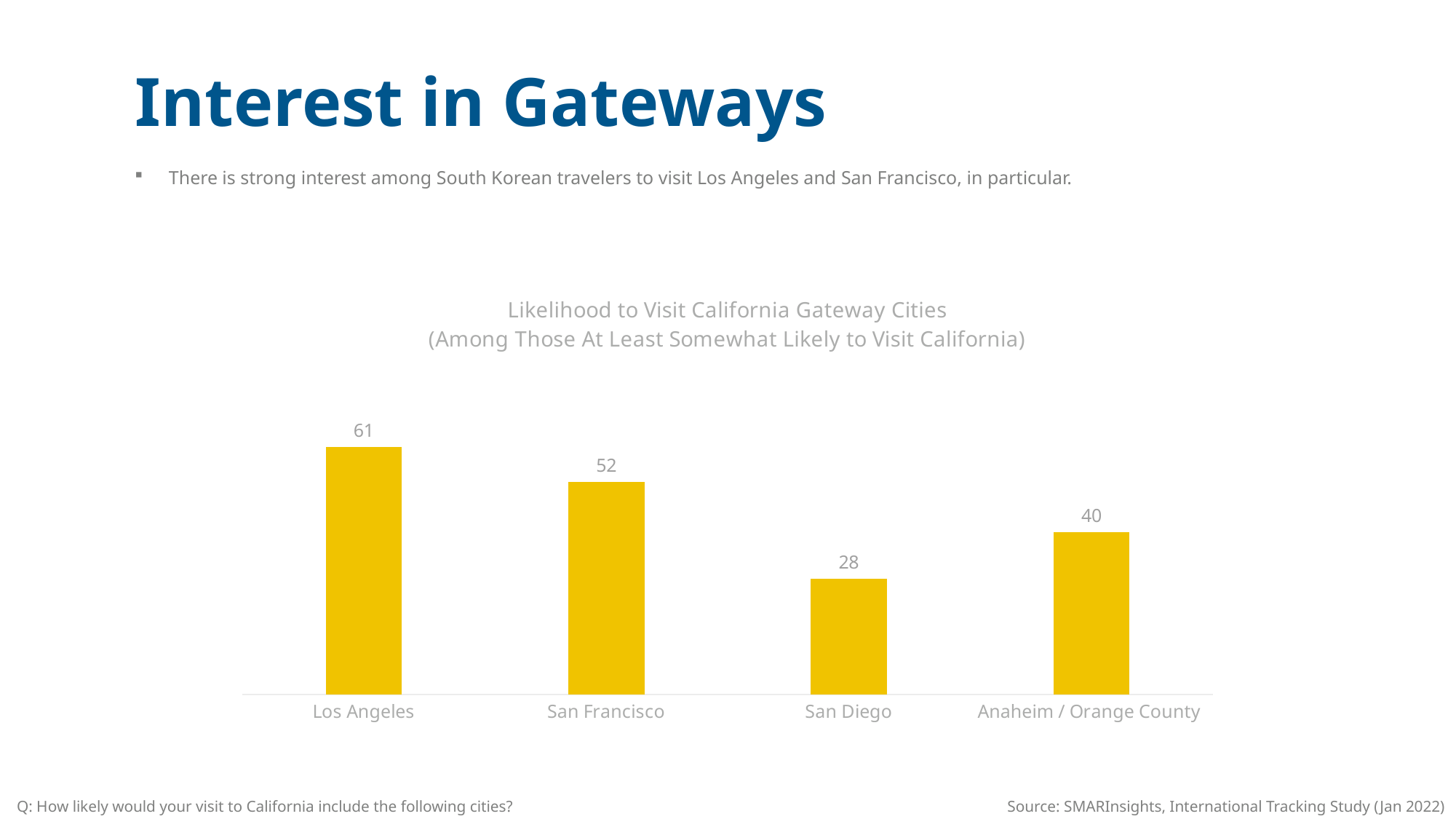
What is the value for Anaheim / Orange County? 40 What is the difference between the values for Los Angeles and San Francisco? 9 What kind of chart is shown on the slide? Bar chart How many cities are shown in the chart? 4 What is the value for San Francisco? 52 What is the value for Los Angeles? 61 What is the difference between the values for Anaheim / Orange County and San Diego? 12 What is the title of the chart? Likelihood to Visit California Gateway Cities (Among Those At Least Somewhat Likely to Visit California) Which has a larger value, San Francisco or Anaheim / Orange County? San Francisco Which city has the highest value? Los Angeles What is the value for San Diego? 28 Which city has the lowest value? San Diego